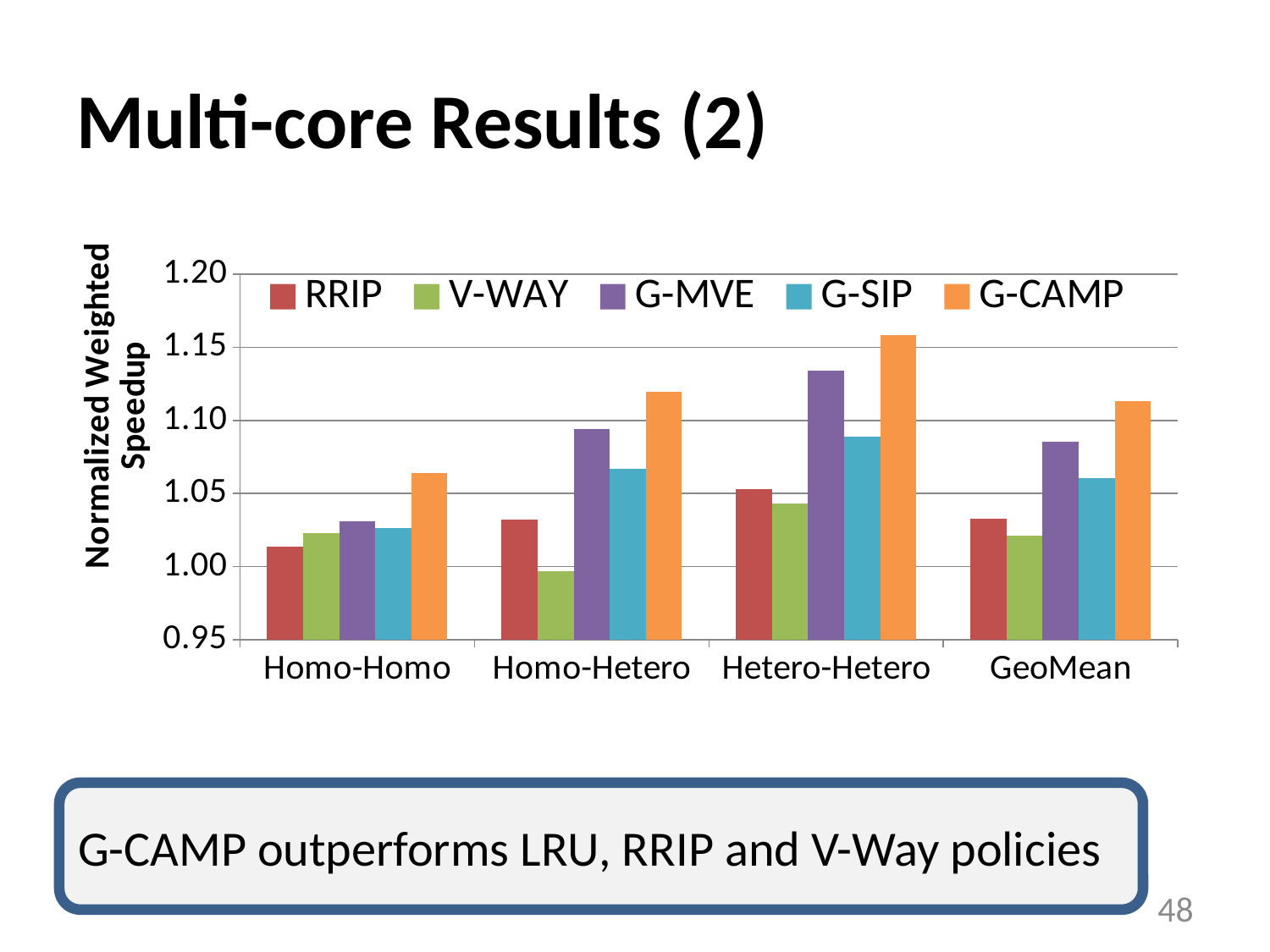
Is the value for G-CAMP in Hetero-Hetero greater or less than 1.15? greater What is the title of the y axis? Normalized Weighted Speedup In which category does G-CAMP reach its highest normalized weighted speedup? Hetero-Hetero In the Homo-Hetero category, which is larger: RRIP or V-WAY? RRIP How many categories are shown on the x axis? 4 Is the value for G-MVE in Hetero-Hetero greater or less than 1.10? greater How many series does the legend list? 5 In the GeoMean category, which is larger: G-MVE or G-SIP? G-MVE Which series has the highest value in the GeoMean category? G-CAMP Which series has the lowest value in the Homo-Hetero category? V-WAY What kind of chart is shown on the slide? bar chart